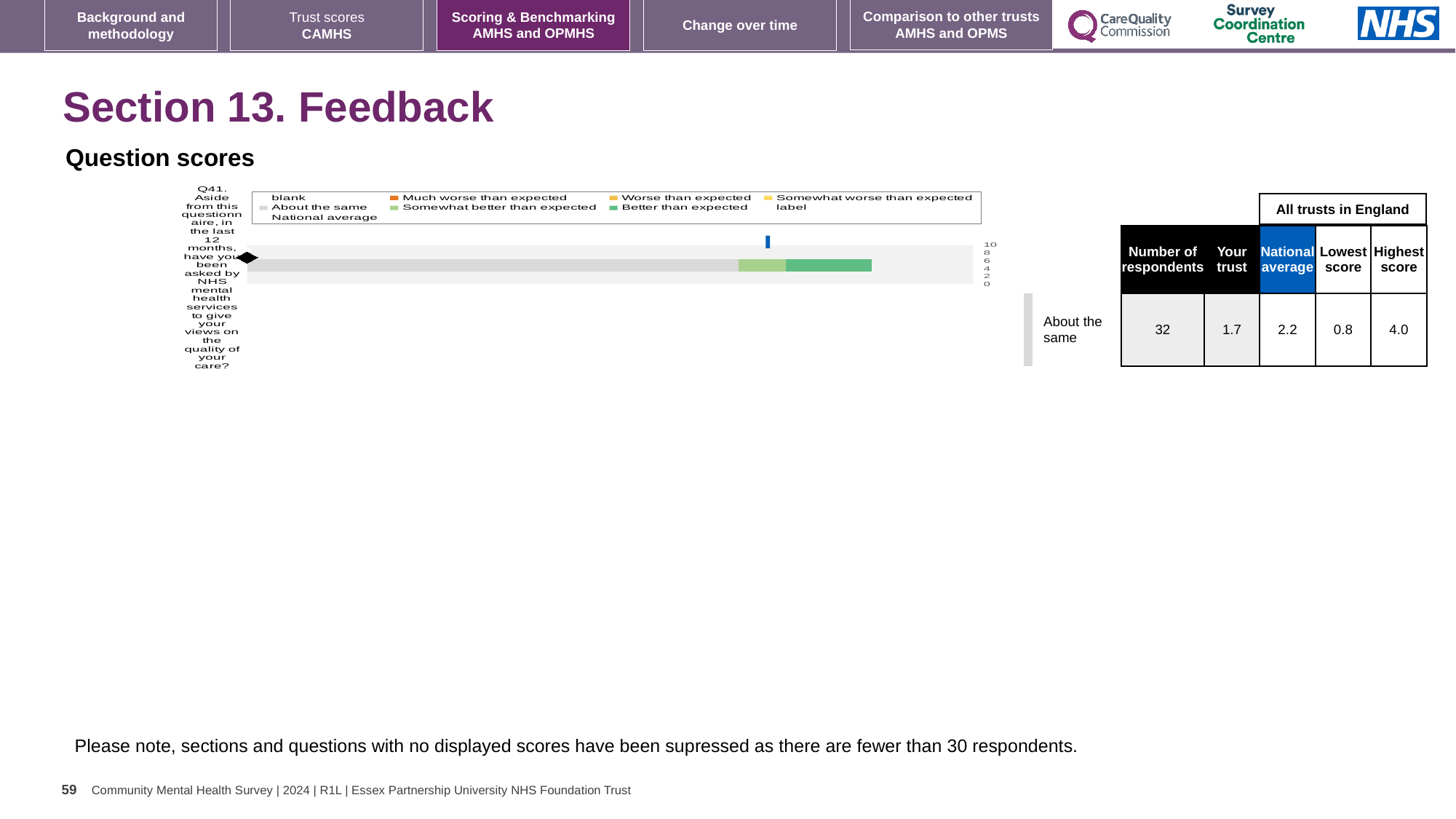
What is the difference between the national average and the trust's score for Q41? 0.5 Which is larger for Q41, the trust's score or the national average? national average What is the lowest score among all trusts in England for Q41? 0.8 What kind of chart is used to show the Q41 question score? bar chart What is the 'Your trust' score for Q41? 1.7 Is the trust's score for Q41 greater or less than 2? less What is the difference between the highest and lowest scores for Q41? 3.2 What is the national average score for Q41? 2.2 How many questions are plotted in the Question scores chart? 1 Which benchmark category is the trust's Q41 score placed in? About the same How many respondents answered Q41? 32 What is the highest score among all trusts in England for Q41? 4.0